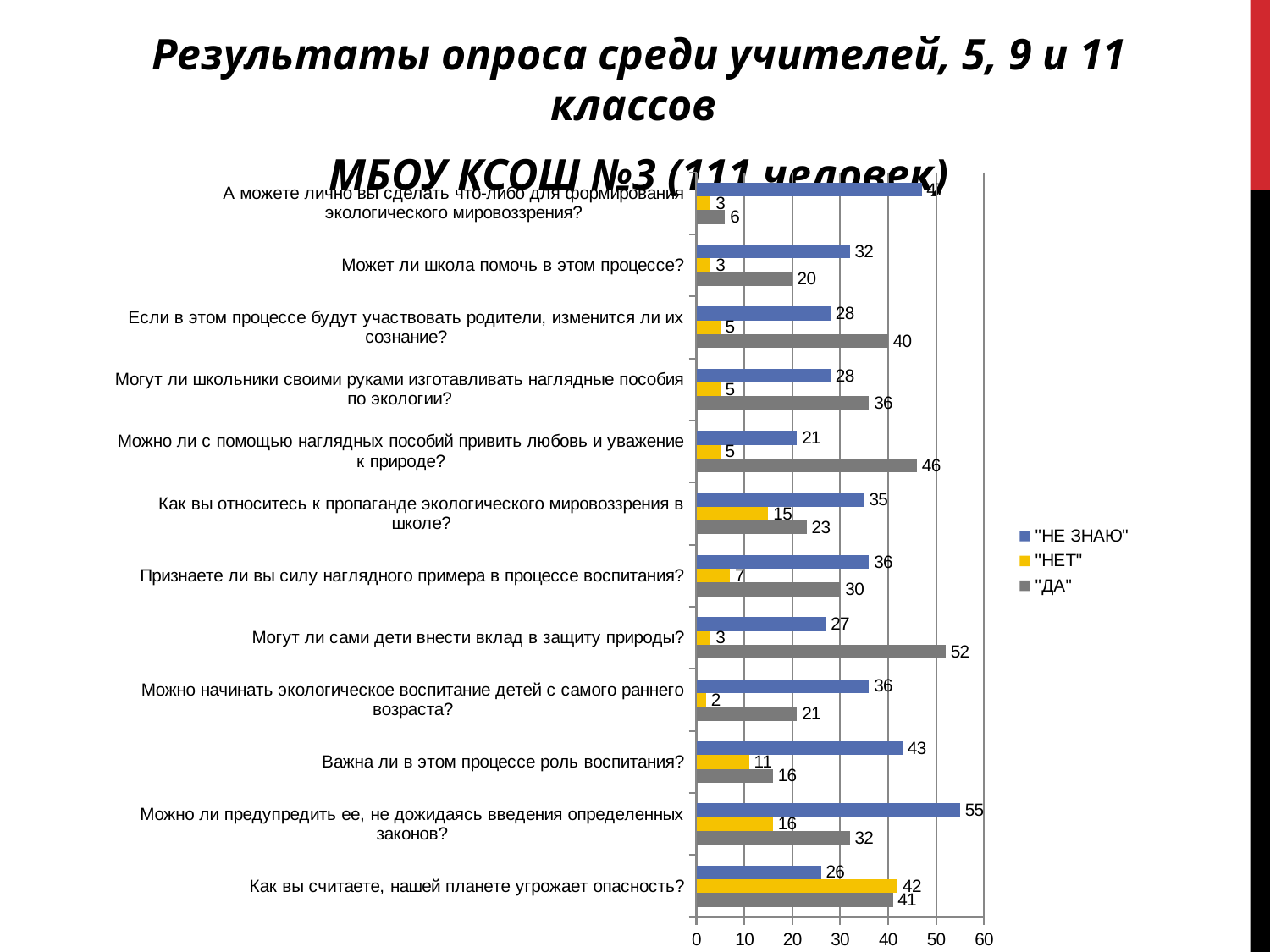
For "Может ли школа помочь в этом процессе?", which is larger: the "НЕ ЗНАЮ" value or the "ДА" value? НЕ ЗНАЮ What is the "НЕТ" value for "Как вы считаете, нашей планете угрожает опасность?" 42 How many series does the legend list? 3 What is the "ДА" value for "Могут ли сами дети внести вклад в защиту природы?" 52 How many survey questions (categories) are plotted on the chart? 12 Which colour represents the "НЕТ" series in the legend? yellow Which category has the lowest "ДА" value? А можете лично вы сделать что-либо для формирования экологического мировоззрения? Is the "ДА" value for "Если в этом процессе будут участвовать родители, изменится ли их сознание?" greater or less than 30? greater Which category has the highest "НЕ ЗНАЮ" value? Можно ли предупредить ее, не дожидаясь введения определенных законов? What kind of chart is shown on the slide? bar chart What is the "НЕ ЗНАЮ" value for "Важна ли в этом процессе роль воспитания?" 43 What is the difference between the "ДА" and "НЕ ЗНАЮ" values for "Можно ли с помощью наглядных пособий привить любовь и уважение к природе?" 25